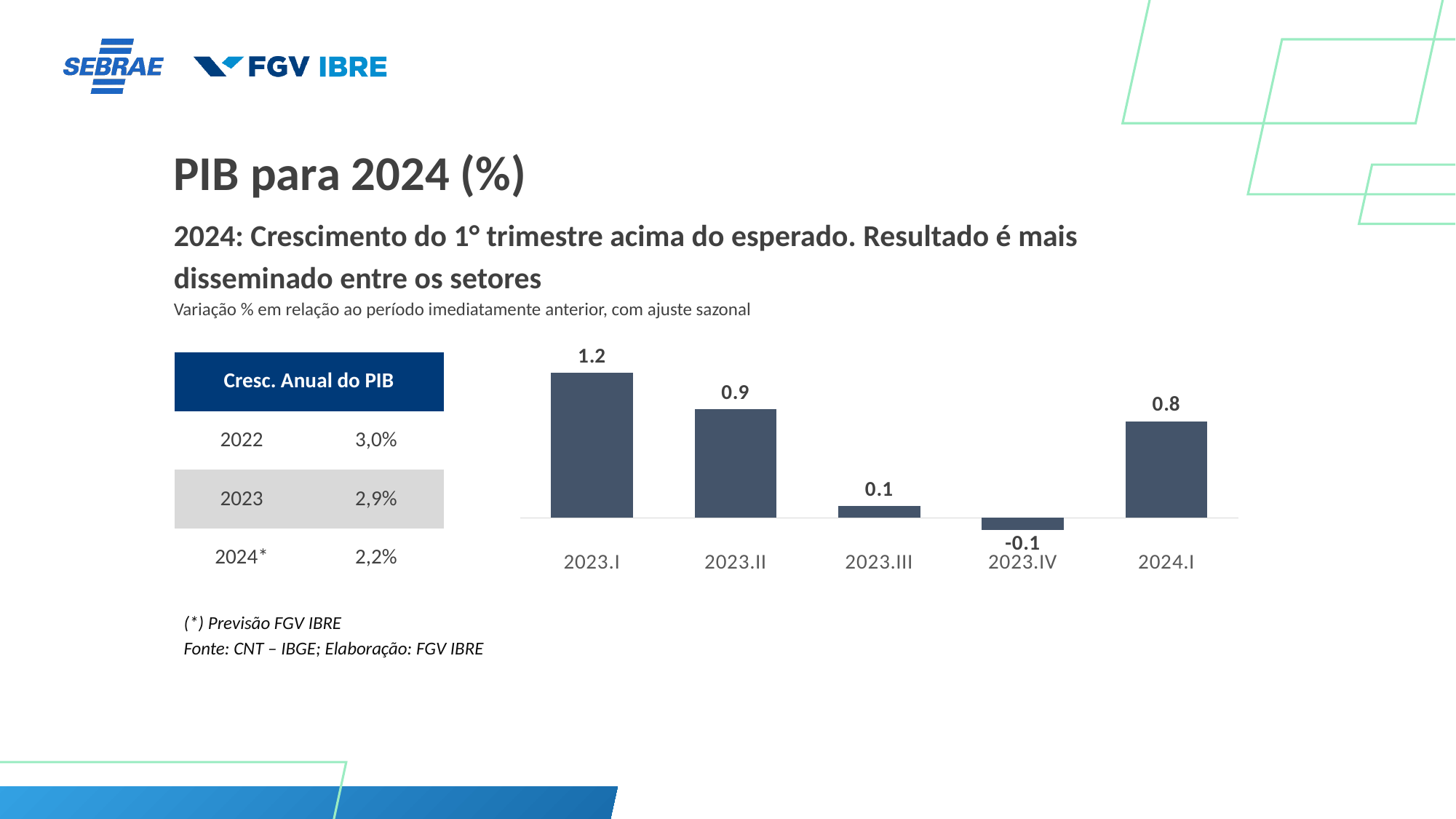
What is the value for 2023.IV in the bar chart? -0.1 What kind of chart is shown on the slide? bar chart Which is larger, the value for 2023.II or the value for 2024.I? 2023.II Which quarter has the highest value in the bar chart? 2023.I What is the value for 2024.I in the bar chart? 0.8 Which quarter has the lowest value in the bar chart? 2023.IV How many quarters are shown in the bar chart? 5 What is the difference between the values for 2024.I and 2023.III? 0.7 What is the difference between the values for 2023.I and 2023.II? 0.3 What is the value for 2023.I in the bar chart? 1.2 Do the values rise or fall from 2023.I to 2023.IV? fall What is the title of the slide containing the chart? PIB para 2024 (%)